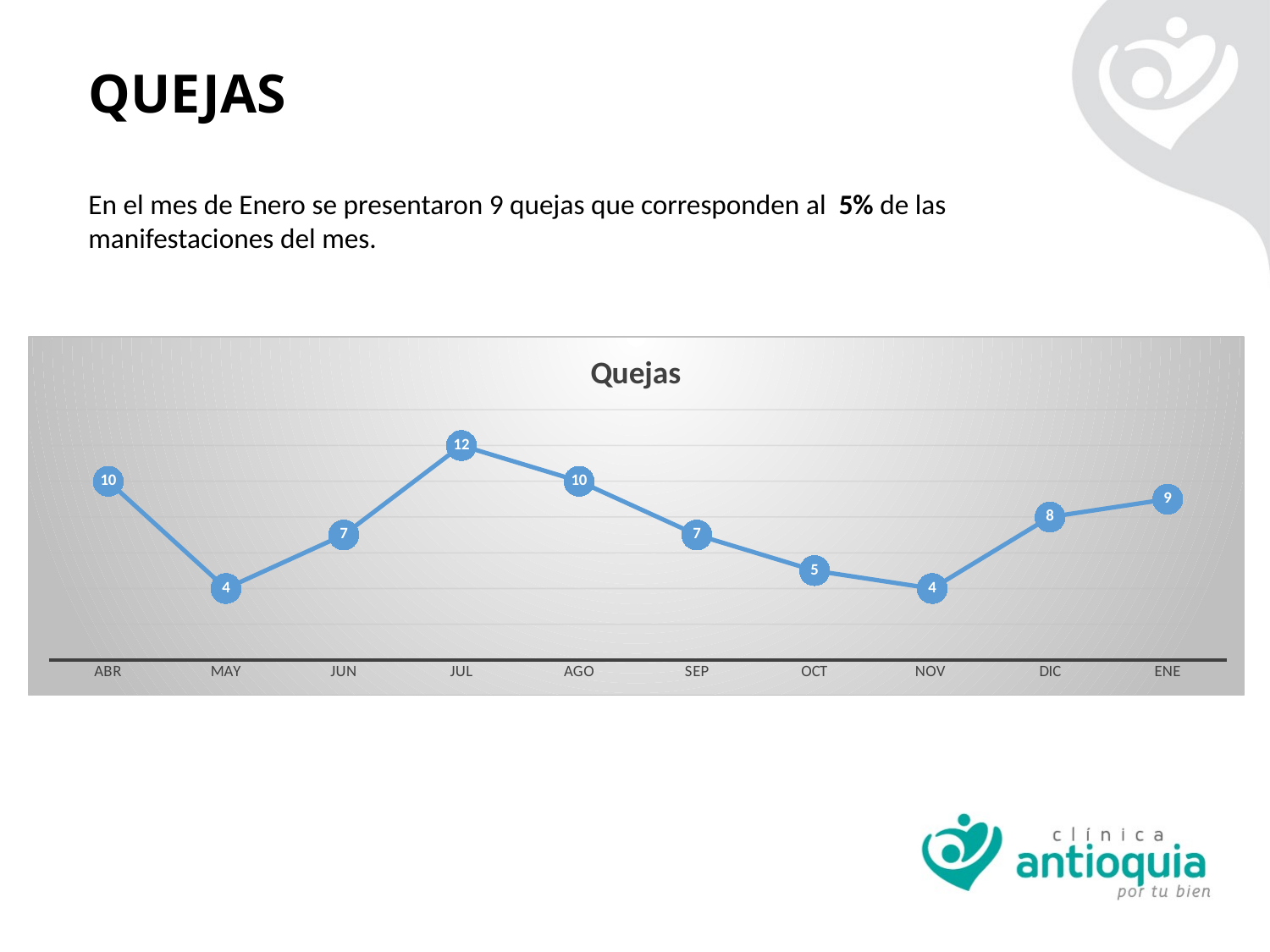
What is the value for JUL? 12 Which is larger, the value for DIC or the value for SEP? DIC What is the value for ENE? 9 What is the title of the chart? Quejas How many months are plotted on the chart? 10 What kind of chart is shown? Line chart What is the difference between the values for ABR and MAY? 6 What is the value for OCT? 5 Which is larger, the value for AGO or the value for OCT? AGO Do the values rise or fall from NOV to ENE? Rise What is the difference between the values for JUL and NOV? 8 Which month has the highest value? JUL